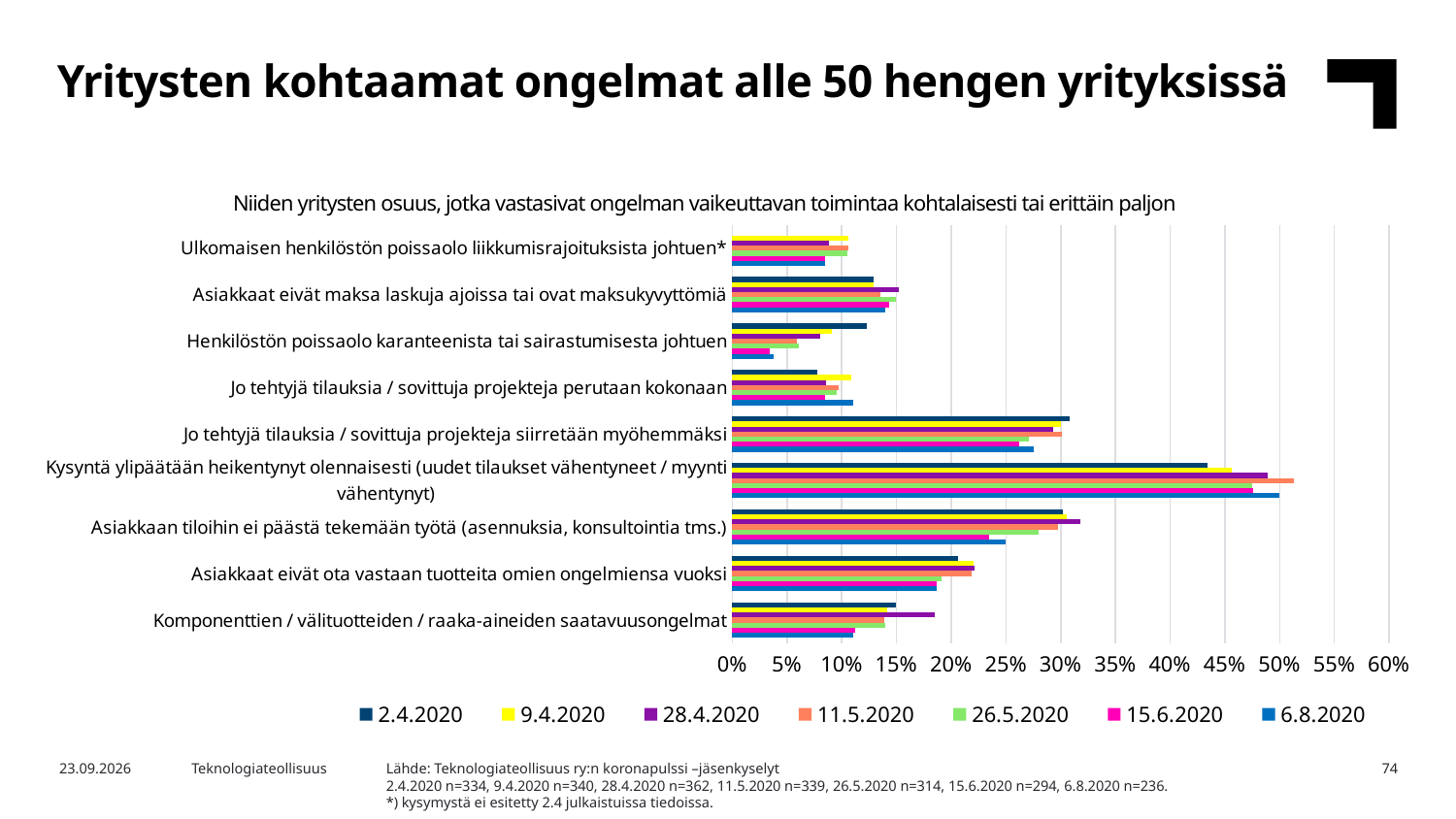
How many series does the legend list? 7 Which category has the highest values across the series? Kysyntä ylipäätään heikentynyt olennaisesti (uudet tilaukset vähentyneet / myynti vähentynyt) What is the title of the slide? Yritysten kohtaamat ongelmat alle 50 hengen yrityksissä For the 6.8.2020 series, which is larger: 'Kysyntä ylipäätään heikentynyt olennaisesti' or 'Asiakkaan tiloihin ei päästä tekemään työtä'? Kysyntä ylipäätään heikentynyt olennaisesti Is the 28.4.2020 value for 'Komponenttien / välituotteiden / raaka-aineiden saatavuusongelmat' greater or less than 15%? greater Is the 2.4.2020 value for 'Jo tehtyjä tilauksia / sovittuja projekteja siirretään myöhemmäksi' greater or less than 25%? greater Is the 2.4.2020 value for 'Kysyntä ylipäätään heikentynyt olennaisesti' greater or less than 40%? greater What kind of chart is shown on the slide? Bar chart What is the first series listed in the legend? 2.4.2020 For the 6.8.2020 series, which category has the lowest value? Henkilöstön poissaolo karanteenista tai sairastumisesta johtuen How many categories (problem types) are plotted on the chart? 9